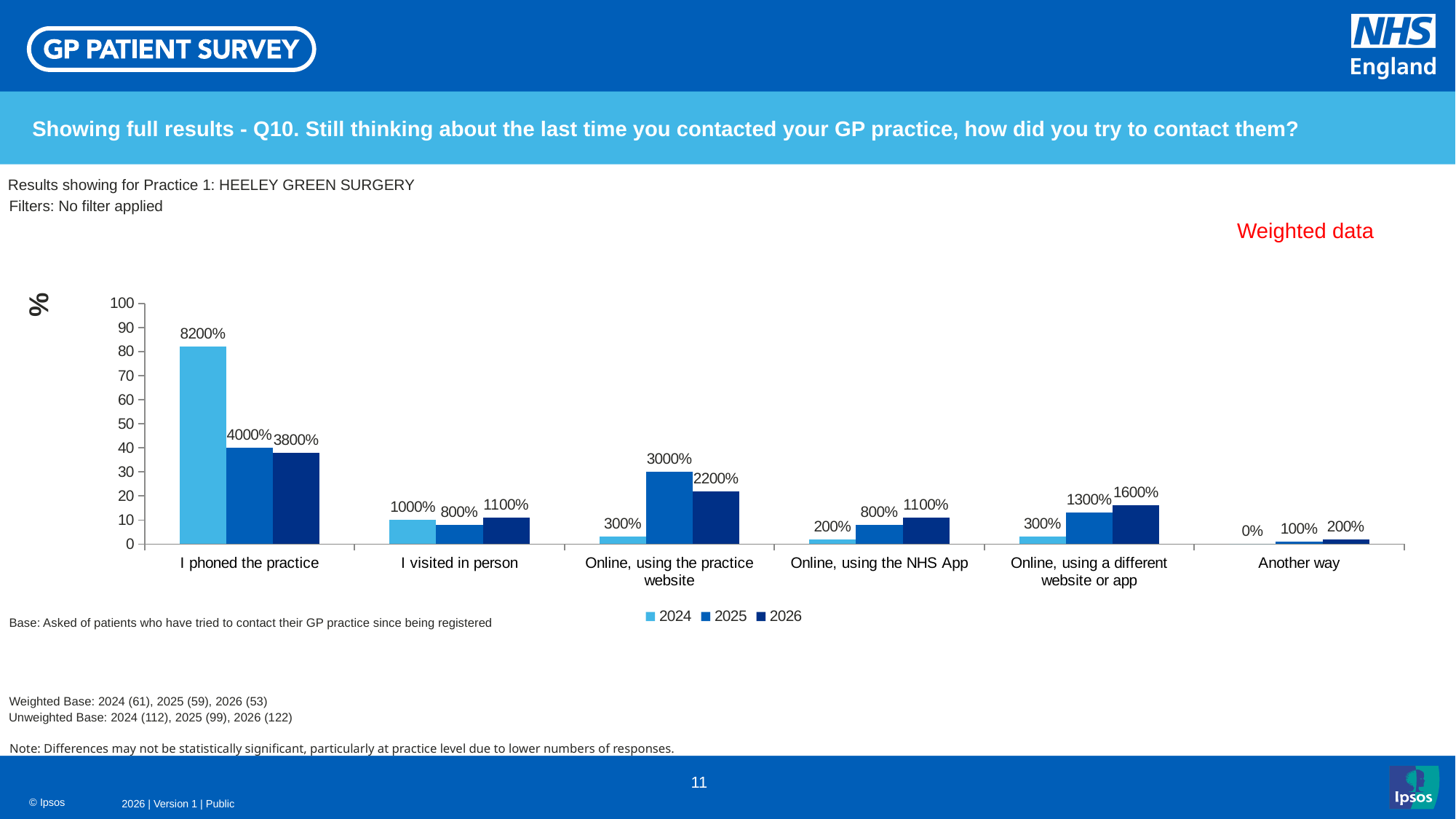
How many series does the legend list? 3 Is the 2024 bar for 'I phoned the practice' greater or less than 80 on the axis? greater What type of chart is shown on the slide? bar chart What is the data label for 2024 in the 'I phoned the practice' category? 8200% Which is larger in the 'Online, using the NHS App' category: the 2025 value or the 2026 value? 2026 How many categories are shown on the x axis? 6 What is the data label for 2026 in the 'Online, using a different website or app' category? 1600% What is the data label for 2024 in the 'Another way' category? 0% Which legend entry is shown in the darkest blue? 2026 What is the data label for 2025 in the 'Online, using the practice website' category? 3000% Which category has the highest 2024 value? I phoned the practice Which category has the lowest 2026 value? Another way